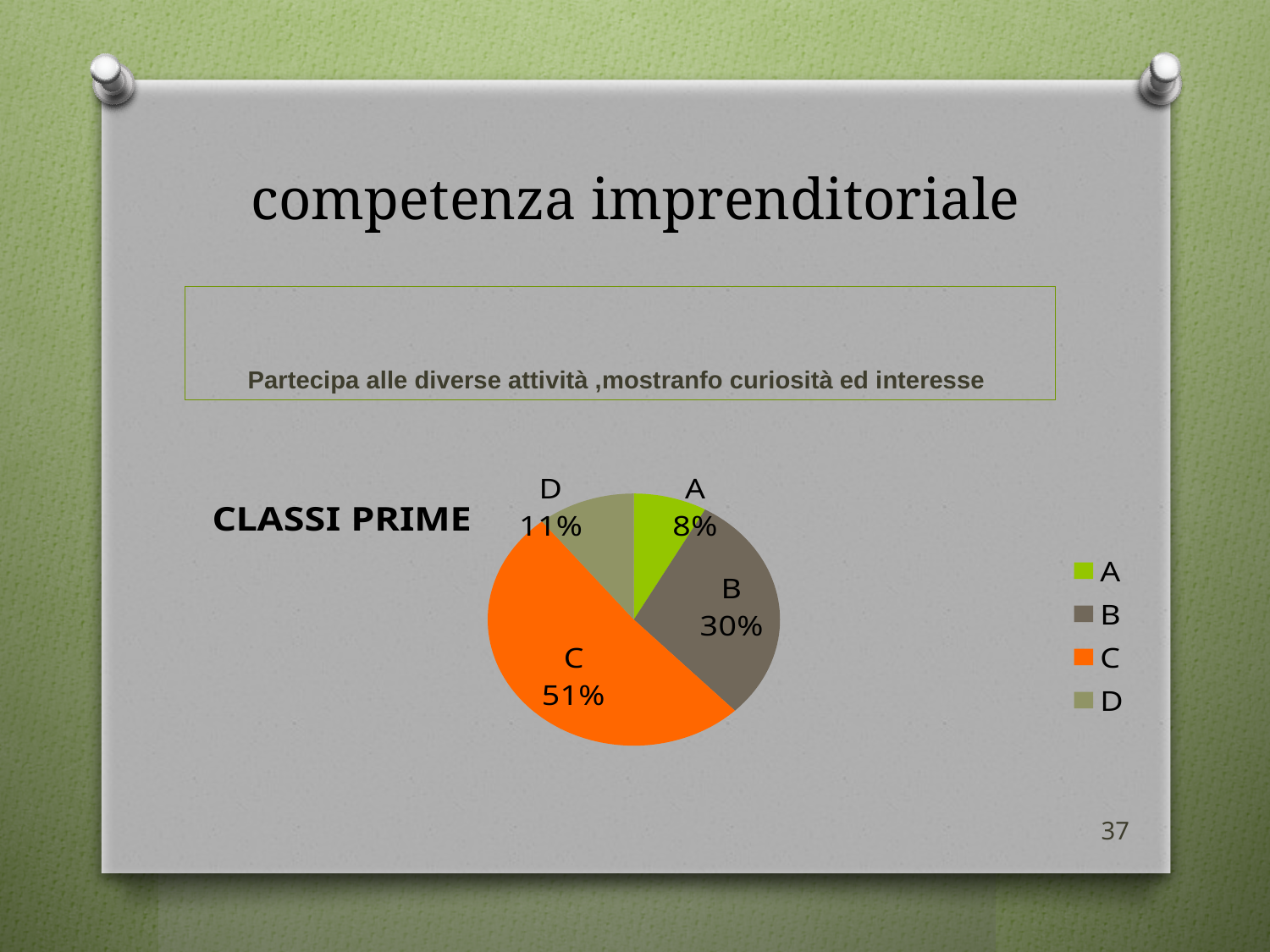
What percentage does slice D represent in the pie chart? 11% What label appears to the left of the pie chart? CLASSI PRIME What kind of chart is shown on the slide? Pie chart What colour is slice C in the pie chart? Orange How many slices does the pie chart have? 4 What percentage does slice B represent in the pie chart? 30% Which is larger, slice B or slice D? B Which category has the smallest slice in the pie chart? A What is the difference in percentage points between slice C and slice B? 21 What percentage does slice C represent in the pie chart? 51% Which category has the largest slice in the pie chart? C What percentage does slice A represent in the pie chart? 8%